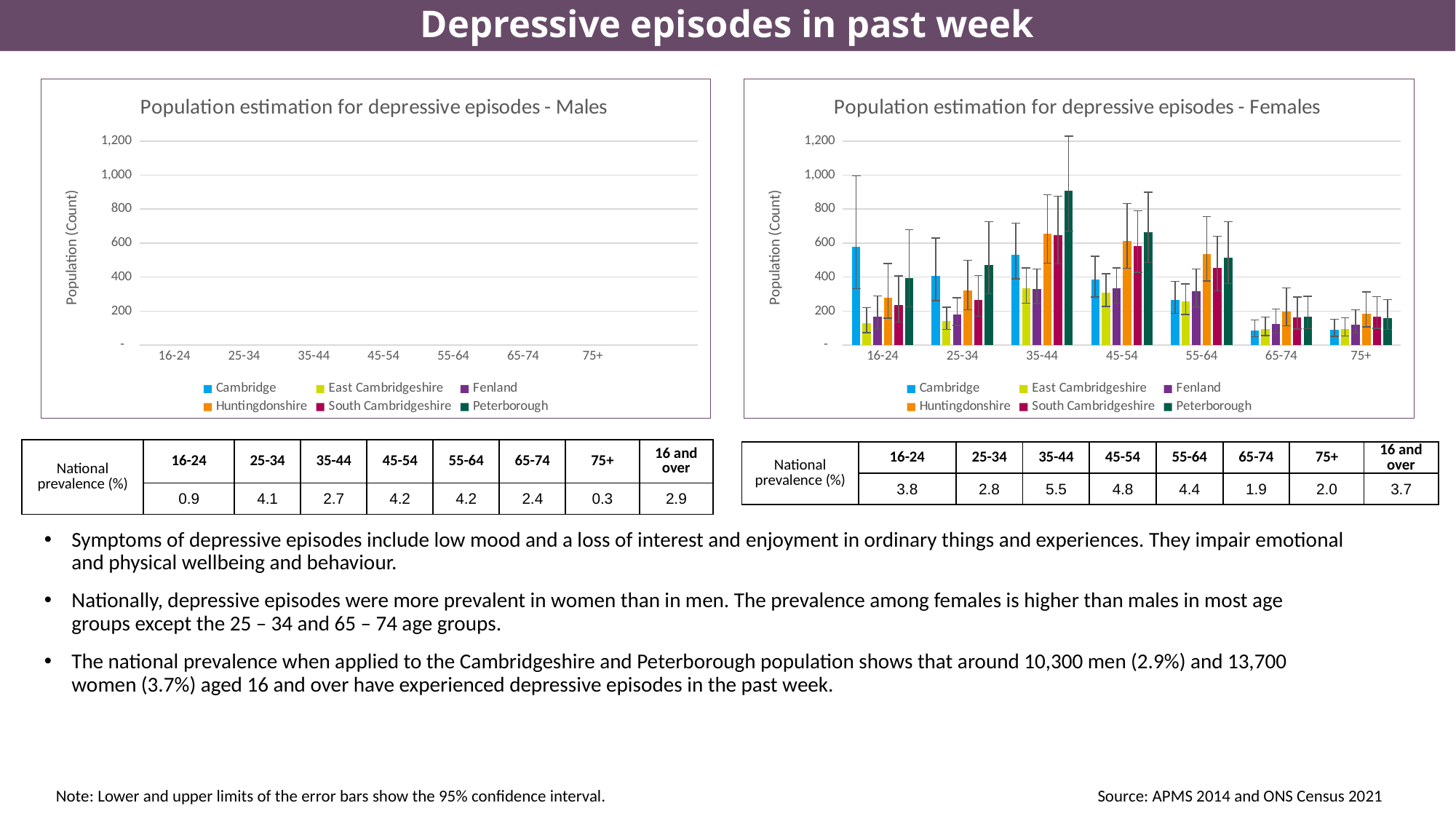
What kind of chart is the 'Population estimation for depressive episodes - Females' chart? bar chart How many series does the legend of the 'Population estimation for depressive episodes - Females' chart list? 6 In the 'Population estimation for depressive episodes - Females' chart, is the value for Peterborough in the 35-44 age group greater or less than 800? greater In the 'Population estimation for depressive episodes - Females' chart, which age group has the tallest Peterborough bar? 35-44 In the 'Population estimation for depressive episodes - Females' chart, which is larger in the 16-24 age group: Cambridge or Peterborough? Cambridge In the 'Population estimation for depressive episodes - Females' chart, which is larger in the 35-44 age group: Huntingdonshire or East Cambridgeshire? Huntingdonshire In the 'Population estimation for depressive episodes - Females' chart, is the value for Cambridge in the 16-24 age group greater or less than 400? greater What is the y-axis label of the 'Population estimation for depressive episodes - Females' chart? Population (Count) What is the title of the chart on the left of the slide? Population estimation for depressive episodes - Males How many age groups are shown on the x axis of the 'Population estimation for depressive episodes - Females' chart? 7 In the 'Population estimation for depressive episodes - Females' chart, which area has the lowest bar in the 16-24 age group? East Cambridgeshire In the 'Population estimation for depressive episodes - Females' chart, is the value for Huntingdonshire in the 55-64 age group greater or less than 400? greater